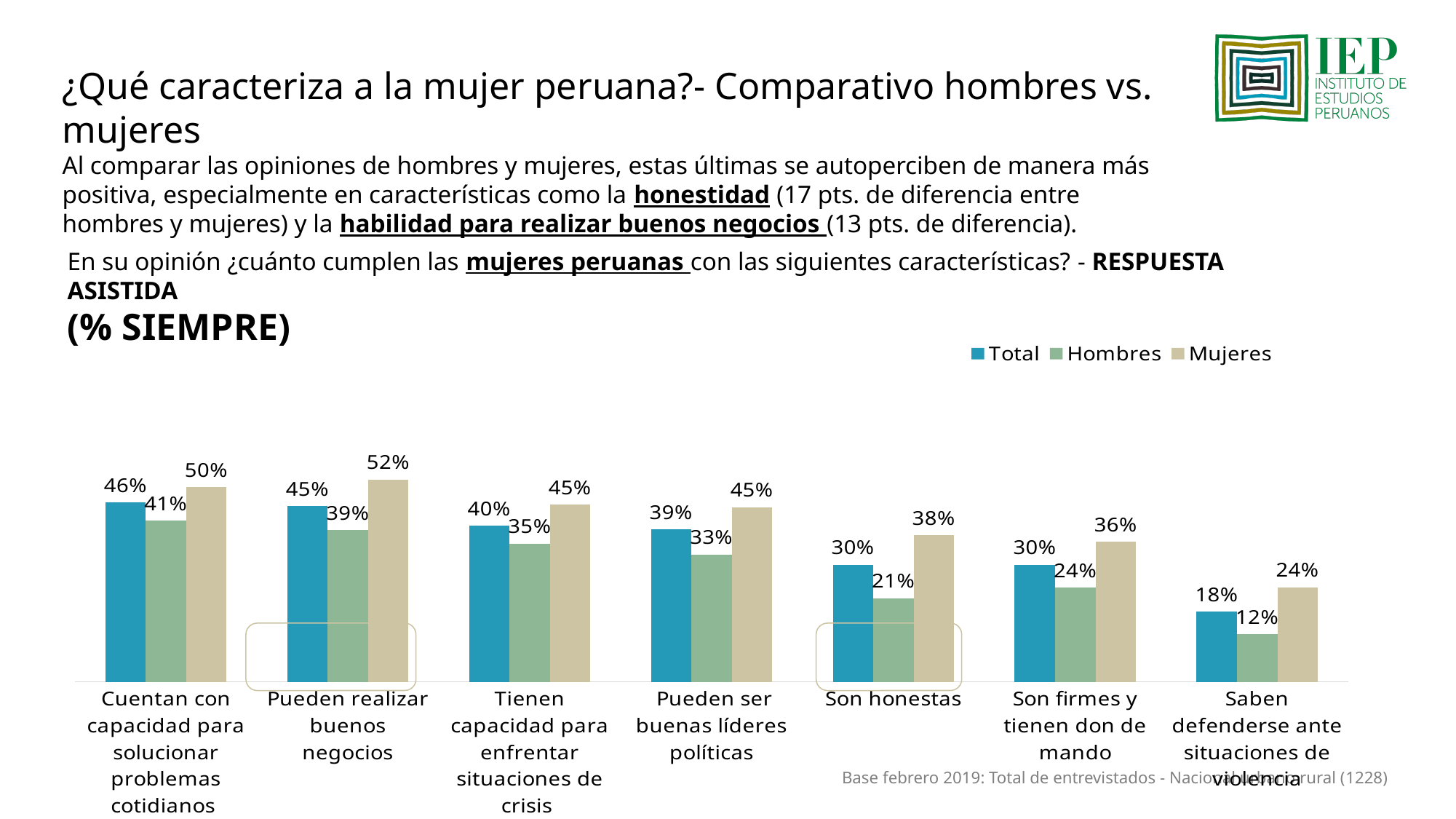
Which series is shown in the lightest (beige) colour in the legend? Mujeres What is the Hombres value for "Son honestas"? 21% How many categories are shown on the x axis of the chart? 7 Which category has the lowest Hombres value? Saben defenderse ante situaciones de violencia What is the difference between the Mujeres and Hombres values for "Son honestas"? 17 percentage points What is the Total value for "Saben defenderse ante situaciones de violencia"? 18% What is the difference between the Mujeres and Hombres values for "Pueden realizar buenos negocios"? 13 percentage points What type of chart is shown on the slide? Bar chart What is the Mujeres value for "Pueden realizar buenos negocios"? 52% Which is larger for "Son firmes y tienen don de mando": the Total value or the Mujeres value? Mujeres How many series does the legend list? 3 Which category has the highest Mujeres value? Pueden realizar buenos negocios